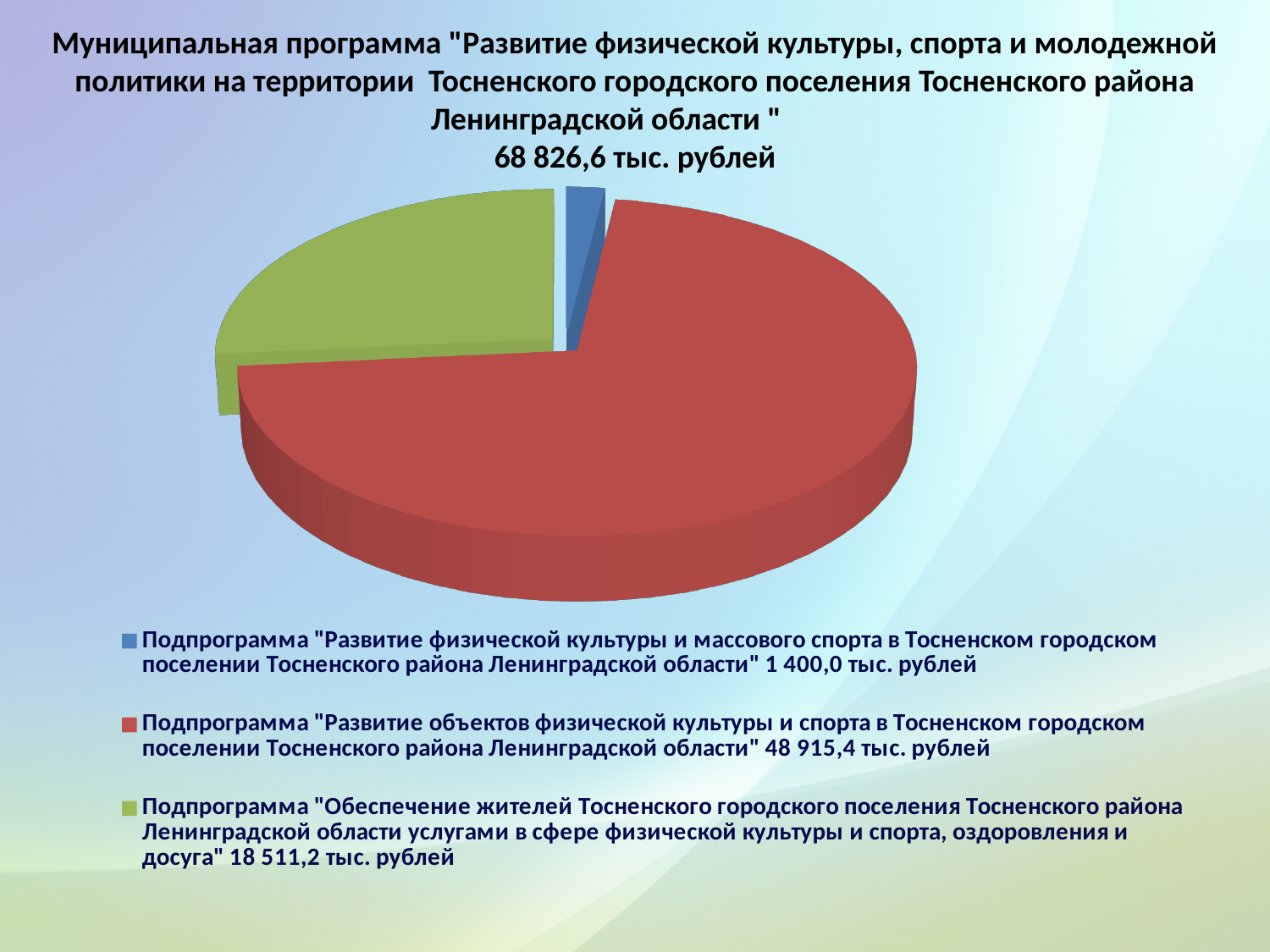
What is the value for the subprogram "Развитие физической культуры и массового спорта в Тосненском городском поселении Тосненского района Ленинградской области"? 1 400,0 тыс. рублей What is the value for the subprogram "Развитие объектов физической культуры и спорта в Тосненском городском поселении Тосненского района Ленинградской области"? 48 915,4 тыс. рублей Which subprogram has the largest slice of the pie? Подпрограмма "Развитие объектов физической культуры и спорта в Тосненском городском поселении Тосненского района Ленинградской области" What is the difference between the value for "Развитие объектов физической культуры и спорта" and the value for "Обеспечение жителей ... услугами в сфере физической культуры и спорта, оздоровления и досуга"? 30 404,2 тыс. рублей How many entries does the legend list? 3 What is the value for the subprogram "Обеспечение жителей Тосненского городского поселения Тосненского района Ленинградской области услугами в сфере физической культуры и спорта, оздоровления и досуга"? 18 511,2 тыс. рублей What is the total amount of the municipal program shown in the chart title? 68 826,6 тыс. рублей What kind of chart is shown on the slide? Pie chart What colour is the slice for the subprogram "Развитие объектов физической культуры и спорта"? Red Which is larger: the value for "Обеспечение жителей ... услугами в сфере физической культуры и спорта, оздоровления и досуга" or the value for "Развитие физической культуры и массового спорта"? Обеспечение жителей ... услугами в сфере физической культуры и спорта, оздоровления и досуга How many slices does the pie chart have? 3 Which subprogram has the smallest slice of the pie? Подпрограмма "Развитие физической культуры и массового спорта в Тосненском городском поселении Тосненского района Ленинградской области"